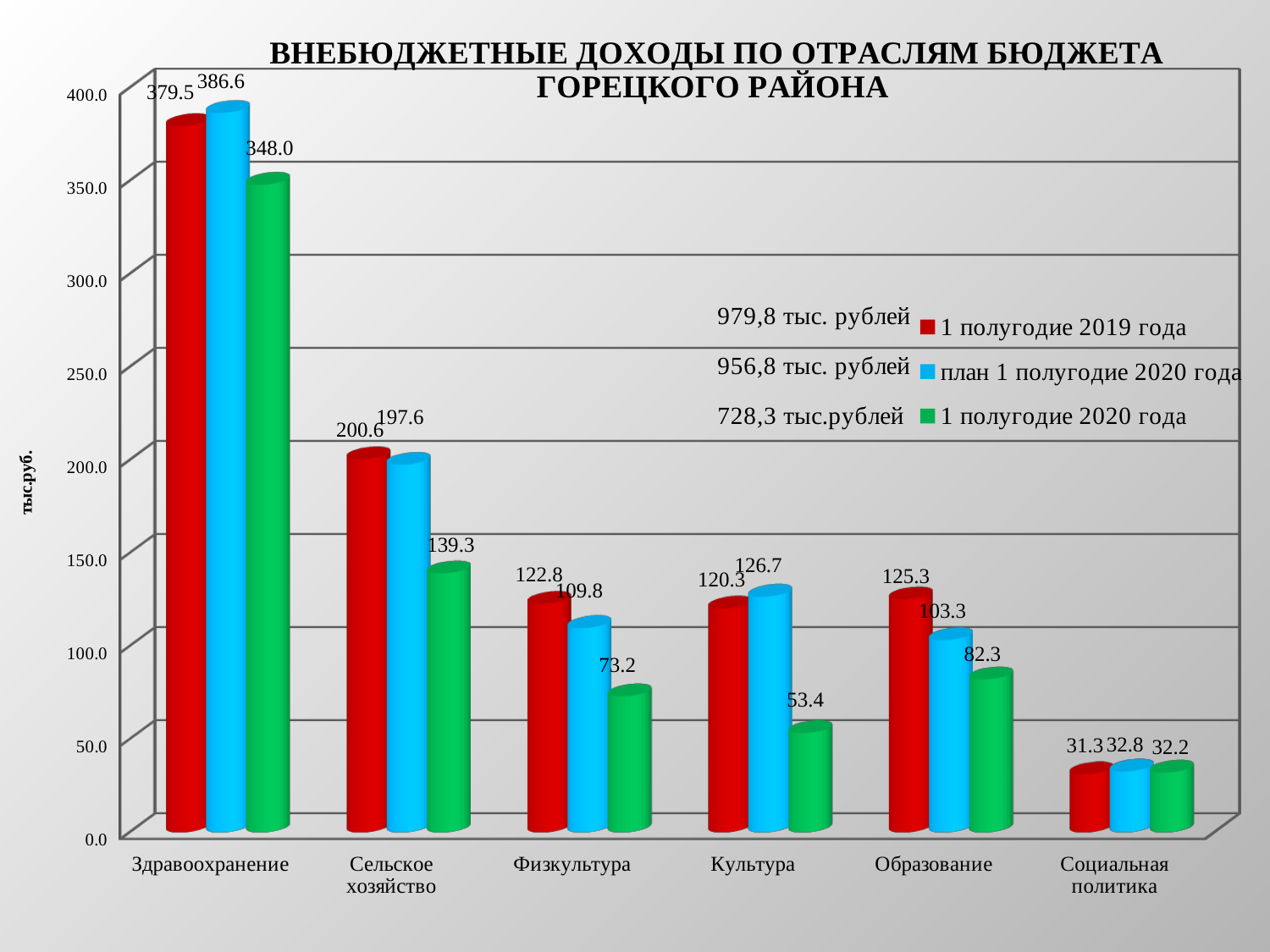
Is the value for Физкультура in the series 1 полугодие 2020 года greater or less than 100.0? less What kind of chart is shown on the slide? bar chart Which category has the lowest value in the series 1 полугодие 2020 года? Социальная политика How many series does the legend list? 3 How many categories are shown on the x axis? 6 What is the value for Здравоохранение in the series 1 полугодие 2020 года? 348.0 For Образование, which is larger: the value for 1 полугодие 2019 года or the value for 1 полугодие 2020 года? 1 полугодие 2019 года What is the label of the vertical axis? тыс.руб. What is the value for Культура in the series план 1 полугодие 2020 года? 126.7 What is the difference between the 1 полугодие 2019 года value and the 1 полугодие 2020 года value for Сельское хозяйство? 61.3 What is the value for Социальная политика in the series 1 полугодие 2019 года? 31.3 Which category has the highest value in the series план 1 полугодие 2020 года? Здравоохранение